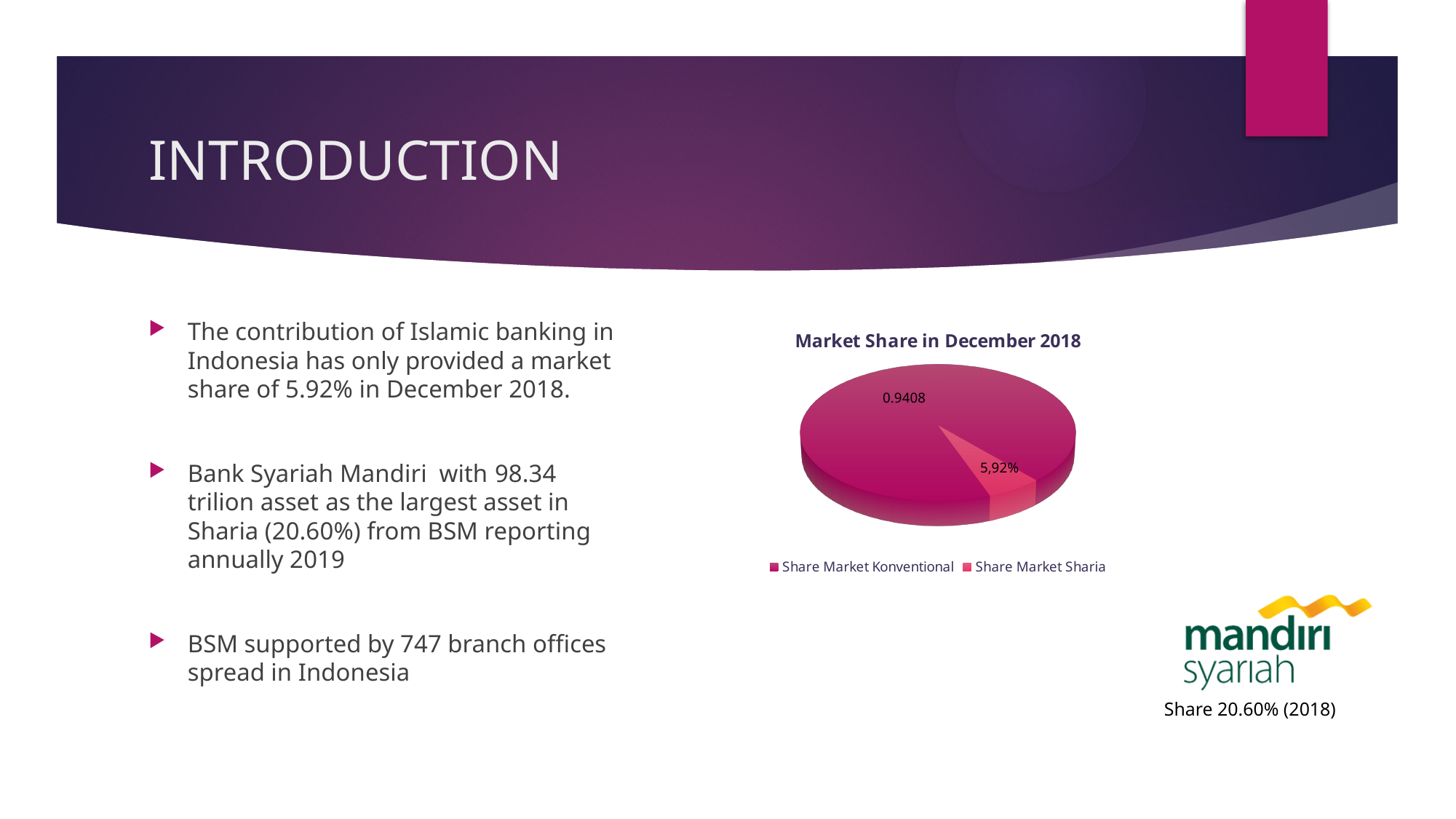
What is the title of the pie chart? Market Share in December 2018 What value is labelled on the Share Market Sharia slice of the pie chart? 5,92% Which slice of the pie chart is the smallest? Share Market Sharia What kind of chart is shown on the slide? pie chart Which slice of the pie chart is the largest? Share Market Konventional What value is labelled on the Share Market Konventional slice of the pie chart? 0.9408 How many slices does the pie chart have? 2 How many entries does the legend of the pie chart list? 2 Which is larger in the pie chart, Share Market Konventional or Share Market Sharia? Share Market Konventional What are the two legend entries of the pie chart? Share Market Konventional and Share Market Sharia